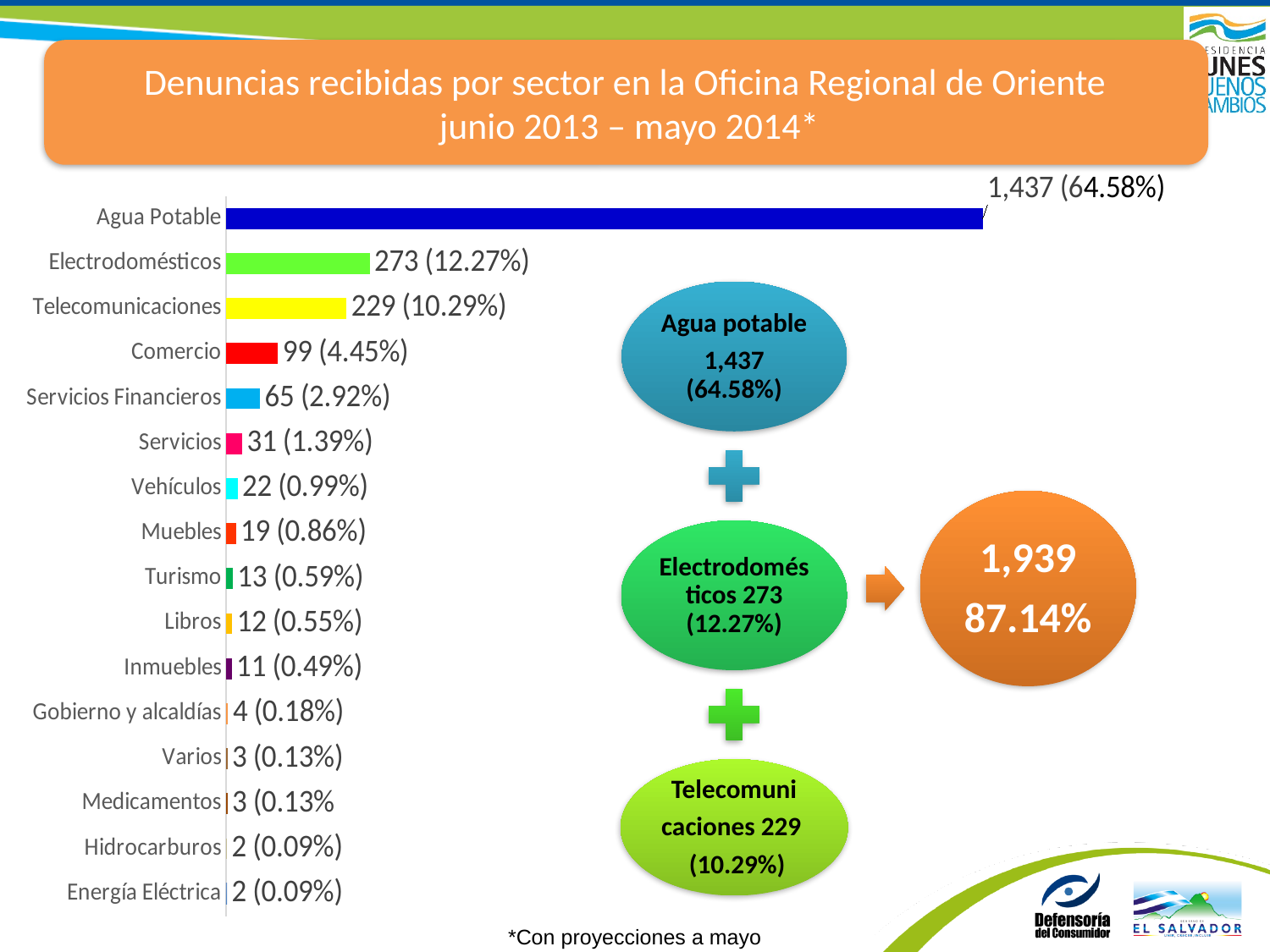
What percentage is shown for Servicios Financieros? 2.92% How many complaints are shown for Agua Potable? 1,437 Which sector received the highest number of complaints (denuncias)? Agua Potable How many complaints are shown for Telecomunicaciones? 229 What kind of chart is shown on the slide? bar chart What is the combined number of complaints for Turismo and Libros? 25 Which has more complaints, Vehículos or Muebles? Vehículos What is the title of the chart on the slide? Denuncias recibidas por sector en la Oficina Regional de Oriente junio 2013 – mayo 2014* What value is shown for Comercio? 99 What percentage is shown for Electrodomésticos? 12.27% What is the difference in complaints between Electrodomésticos and Telecomunicaciones? 44 How many sectors (categories) are plotted in the bar chart? 16